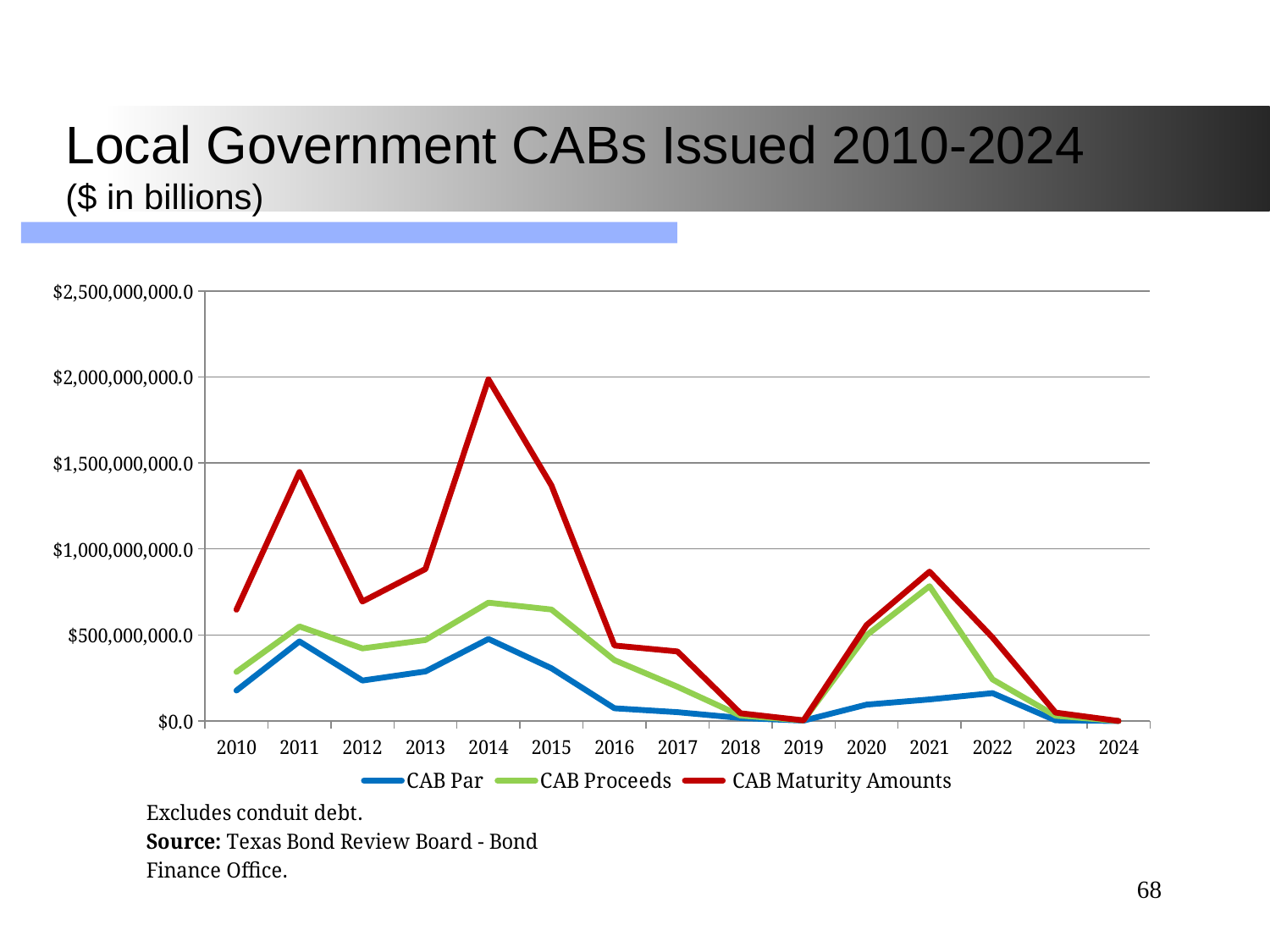
In which year does CAB Maturity Amounts reach its highest value? 2014 Is the value for CAB Maturity Amounts in 2012 greater or less than $1,000,000,000.0? less Do the CAB Maturity Amounts values rise or fall from 2014 to 2019? fall How many years are plotted along the x axis? 15 What colour is the CAB Maturity Amounts line? red Which is larger for CAB Par: the value in 2016 or the value in 2022? 2022 How many series does the legend list? 3 Which series has the lowest value in 2014? CAB Par Is the value for CAB Maturity Amounts in 2014 greater or less than $1,500,000,000.0? greater What kind of chart is shown on the slide? line chart Which is larger for CAB Maturity Amounts: the value in 2011 or the value in 2014? 2014 Is the value for CAB Proceeds in 2021 greater or less than $500,000,000.0? greater